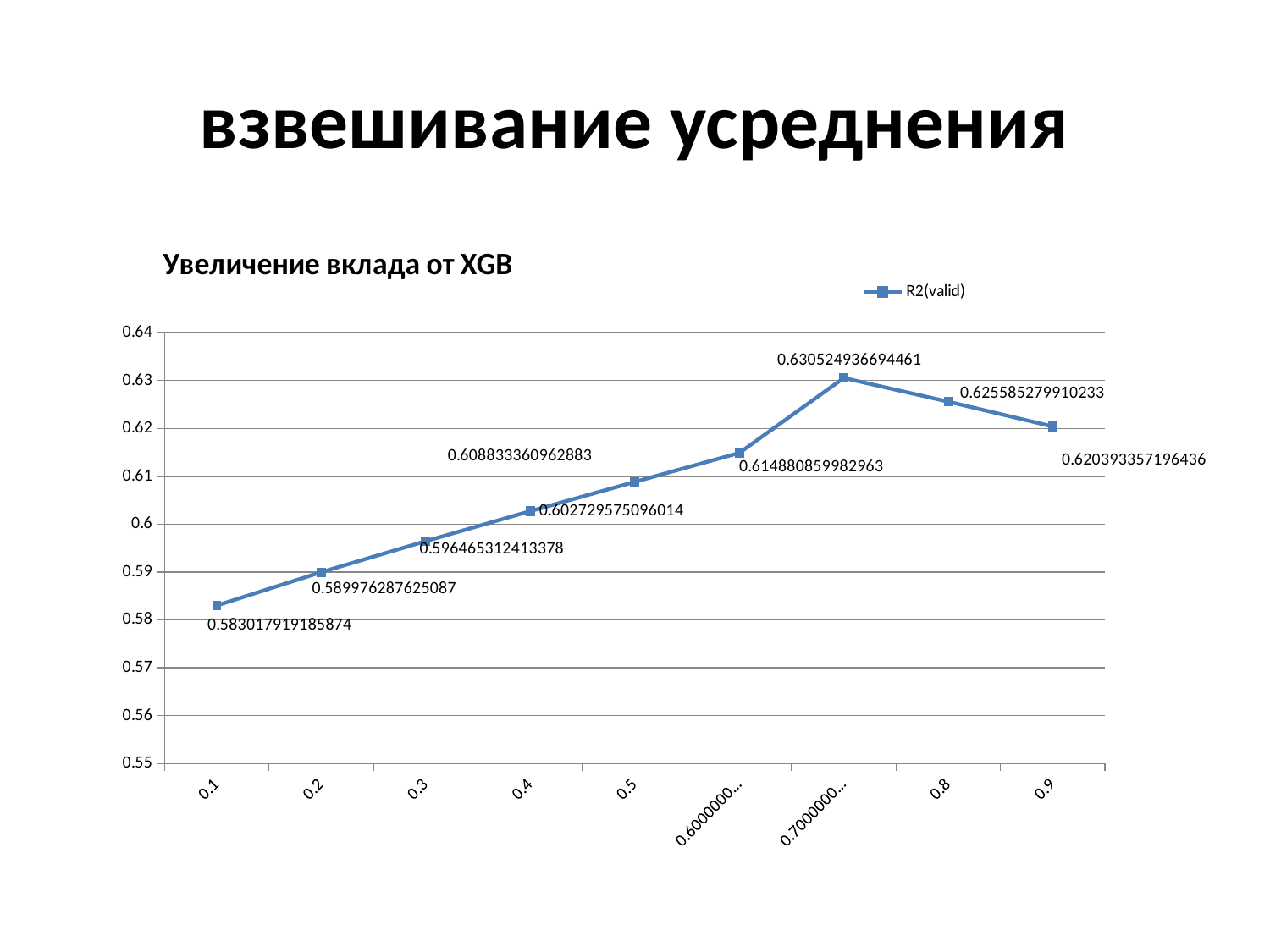
Is the R2(valid) value at 0.8 greater or less than 0.62? greater What is the difference between the R2(valid) values at 0.7000000… and 0.8? 0.004939656784228 Which is larger, the R2(valid) value at 0.8 or at 0.9? 0.8 How many series does the legend list? 1 At which x-axis category is R2(valid) highest? 0.7000000… What is the R2(valid) value at 0.4? 0.602729575096014 What is the R2(valid) value at 0.1? 0.583017919185874 How many data points are plotted on the line? 9 What is the R2(valid) value at 0.9? 0.620393357196436 What type of chart is shown on the slide? line chart What is the title of the chart? Увеличение вклада от XGB At which x-axis category is R2(valid) lowest? 0.1